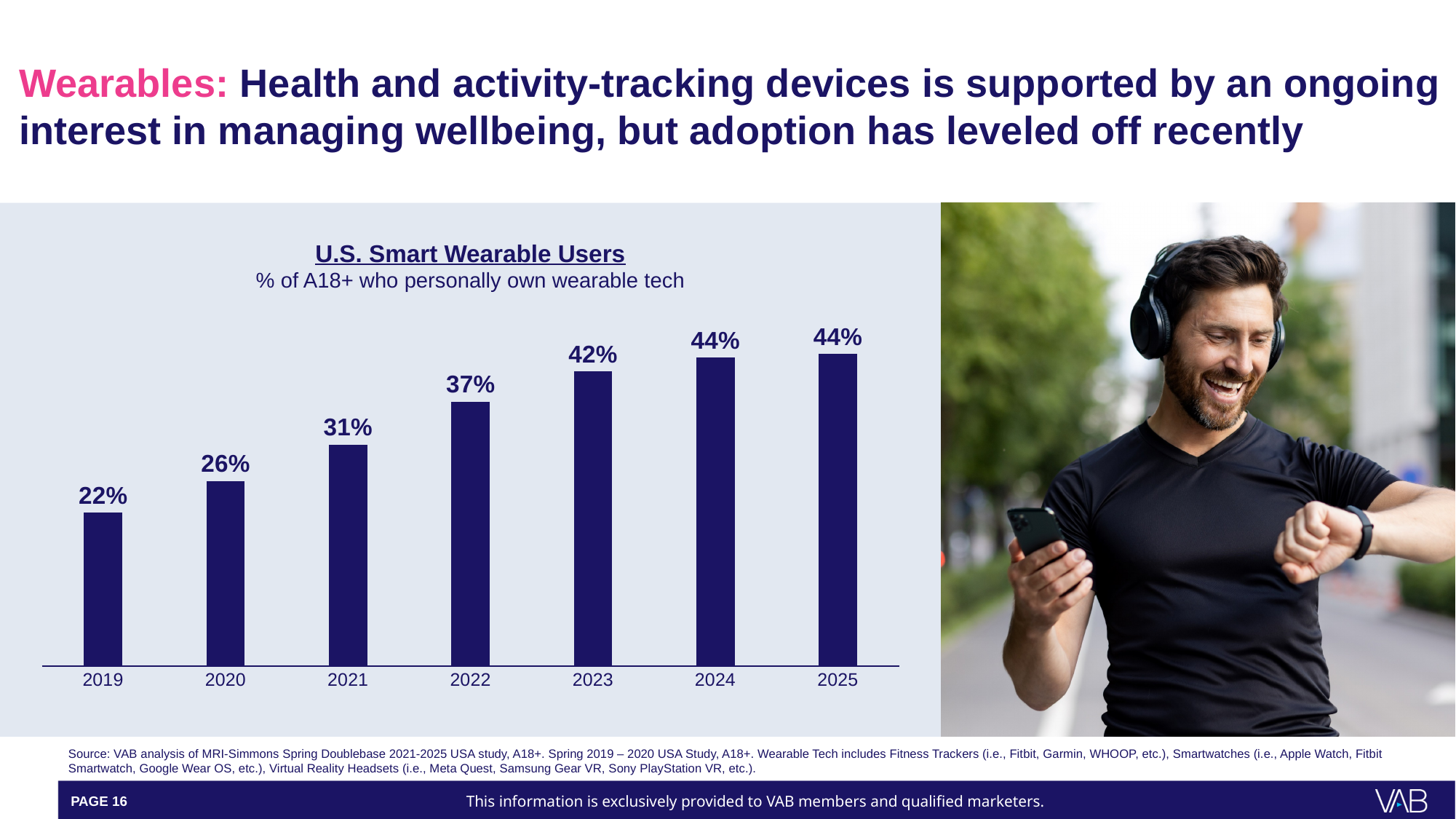
What is the difference in percentage points between 2025 and 2019? 22 What is the title of the chart? U.S. Smart Wearable Users What does the chart's subtitle say the values represent? % of A18+ who personally own wearable tech Do the values generally rise or fall from 2019 to 2025? Rise How many years are shown on the x axis of the chart? 7 Which year has the lowest share of smart wearable users? 2019 What is the value shown for 2025? 44% What is the difference in percentage points between 2021 and 2020? 5 What is the value shown for 2022 in the U.S. Smart Wearable Users chart? 37% Which year has a higher value, 2021 or 2023? 2023 What kind of chart is used to show U.S. Smart Wearable Users? Bar chart What percentage of U.S. adults 18+ personally owned wearable tech in 2019? 22%